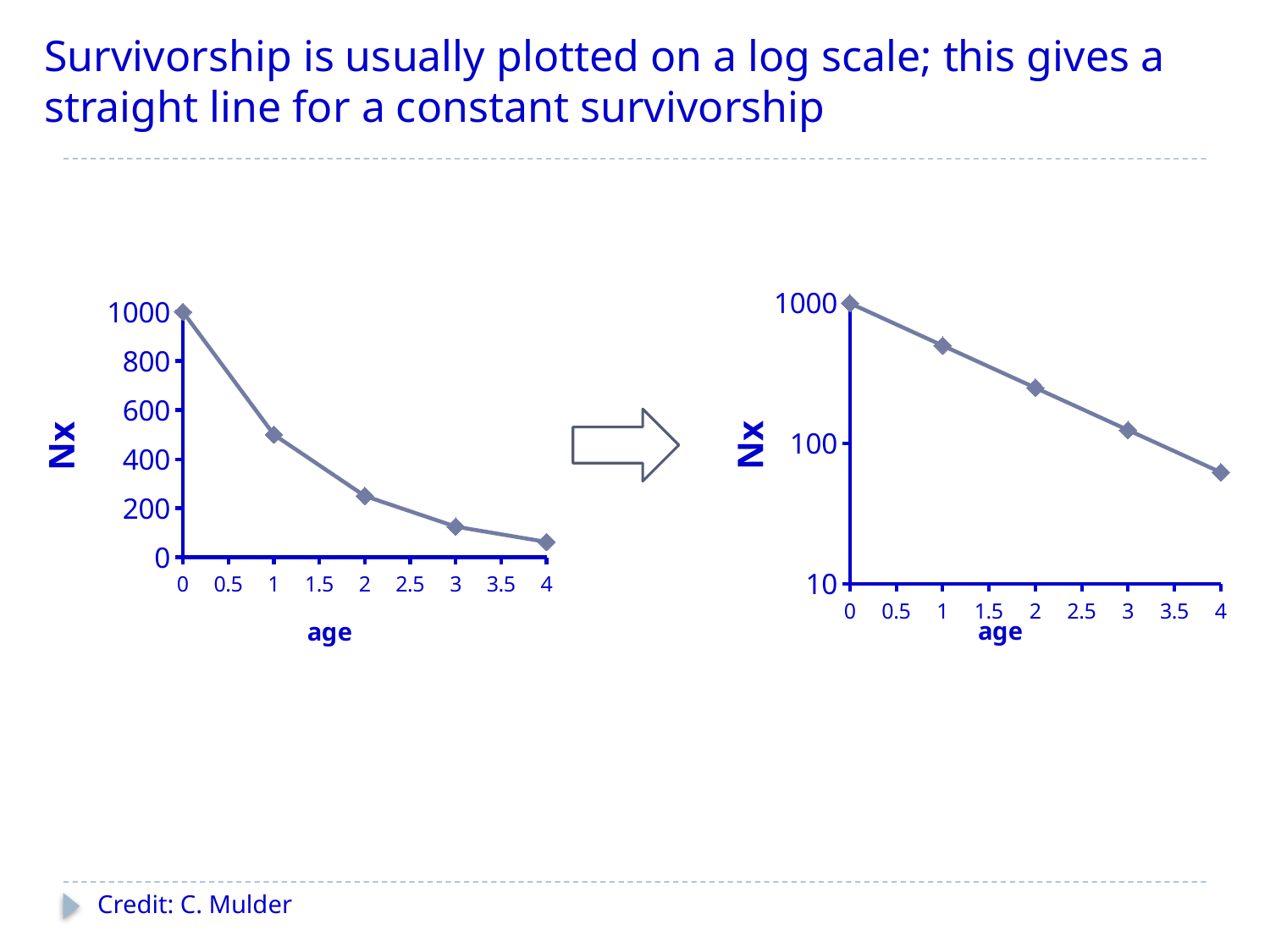
On the left chart, at which age is Nx lowest? 4 On the left chart, is the value of Nx at age 2 greater or less than 400? less On the left chart, is the value of Nx at age 1 greater or less than 400? greater On the left chart, is the value of Nx at age 3 greater or less than 200? less On the left chart, at which age is Nx highest? 0 On the right chart, does Nx rise or fall as age increases? fall What kind of chart is the left chart? line chart On the left chart, what is the value of Nx at age 0? 1000 On the left chart, which has the larger Nx value, age 1 or age 3? age 1 How many data points are plotted on the right chart? 5 On the right chart, what is the value of Nx at age 0? 1000